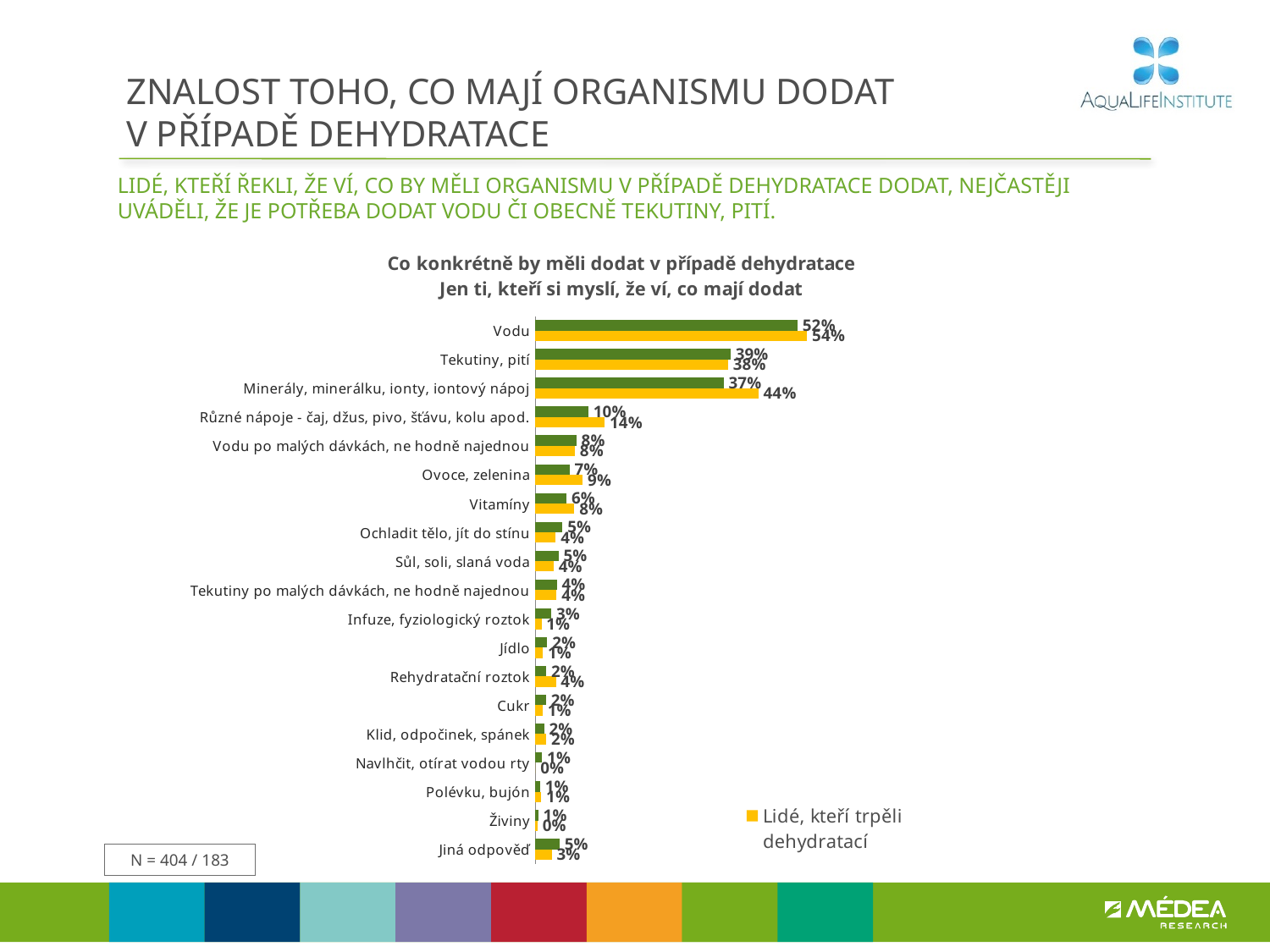
How many categories are shown on the chart? 19 How many series does the legend list? 1 What is the value of the green bar for "Minerály, minerálku, ionty, iontový nápoj"? 37% What is the value of the yellow bar (Lidé, kteří trpěli dehydratací) for "Různé nápoje - čaj, džus, pivo, šťávu, kolu apod."? 14% What is the difference between the yellow and green bars for "Minerály, minerálku, ionty, iontový nápoj"? 7% What is the difference between the green and yellow bars for "Jiná odpověď"? 2% For "Ovoce, zelenina", which bar is larger, the green one or the yellow one? the yellow one What is the value of the yellow bar (Lidé, kteří trpěli dehydratací) for "Vodu"? 54% Which category has the highest value for the yellow series (Lidé, kteří trpěli dehydratací)? Vodu What is the first line of the chart title? Co konkrétně by měli dodat v případě dehydratace What type of chart is shown on the slide? bar chart What is the value of the green bar for "Tekutiny, pití"? 39%